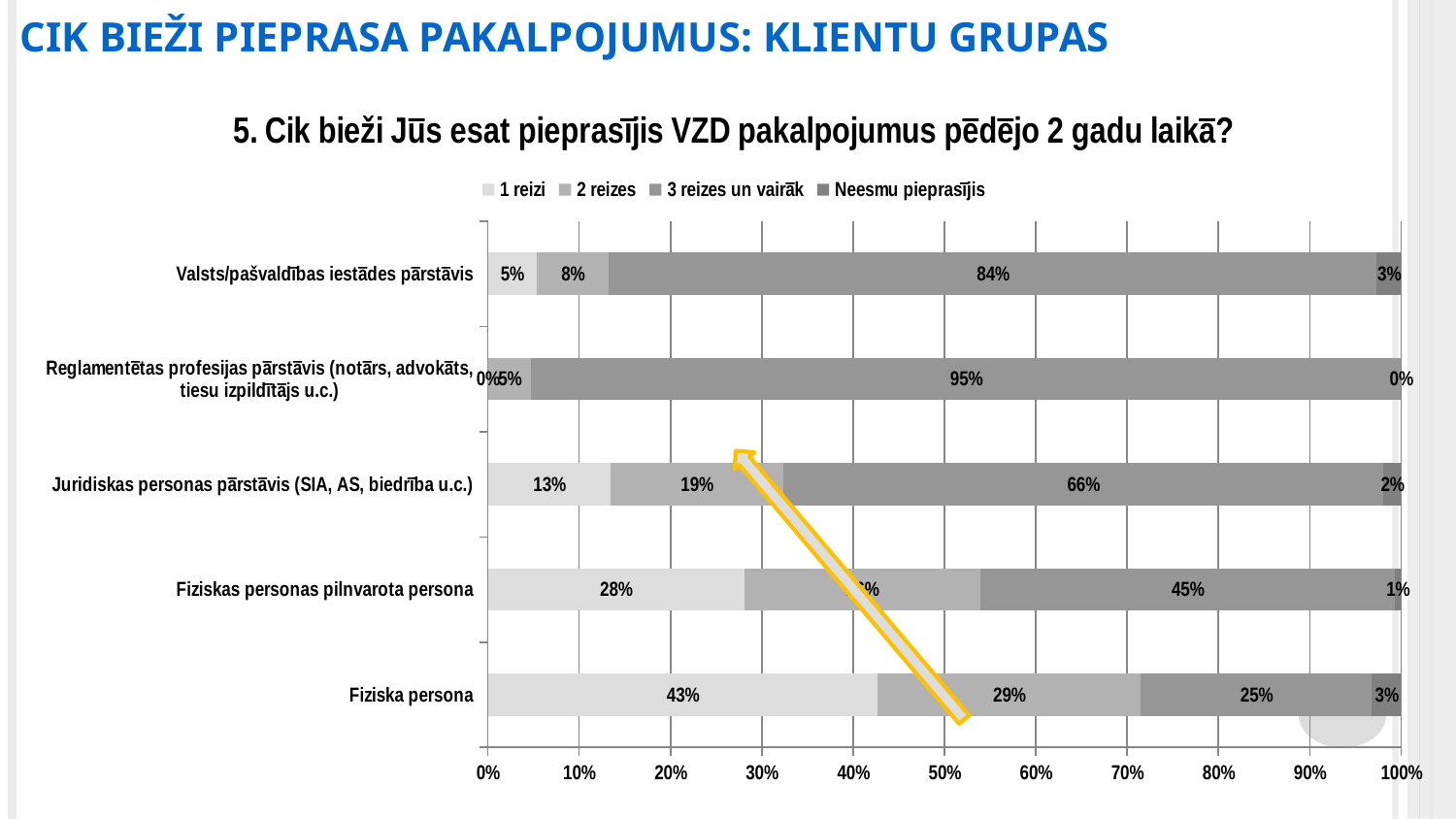
What is the value of '3 reizes un vairāk' for 'Reglamentētas profesijas pārstāvis (notārs, advokāts, tiesu izpildītājs u.c.)'? 95% What is the difference between the '3 reizes un vairāk' share for 'Juridiskas personas pārstāvis (SIA, AS, biedrība u.c.)' and for 'Fiziska persona'? 41 percentage points What is the value of '3 reizes un vairāk' for 'Fiziskas personas pilnvarota persona'? 45% What kind of chart is shown on the slide? bar chart Which client group has the highest share for '1 reizi'? Fiziska persona What is the value of '1 reizi' for 'Fiziska persona'? 43% What is the value of '3 reizes un vairāk' for 'Valsts/pašvaldības iestādes pārstāvis'? 84% Which has a larger '1 reizi' share: 'Juridiskas personas pārstāvis (SIA, AS, biedrība u.c.)' or 'Valsts/pašvaldības iestādes pārstāvis'? Juridiskas personas pārstāvis (SIA, AS, biedrība u.c.) What is the first entry in the chart legend? 1 reizi How many client groups (categories) are plotted in the chart? 5 How many series does the chart legend list? 4 Which client group has the highest share for '3 reizes un vairāk'? Reglamentētas profesijas pārstāvis (notārs, advokāts, tiesu izpildītājs u.c.)